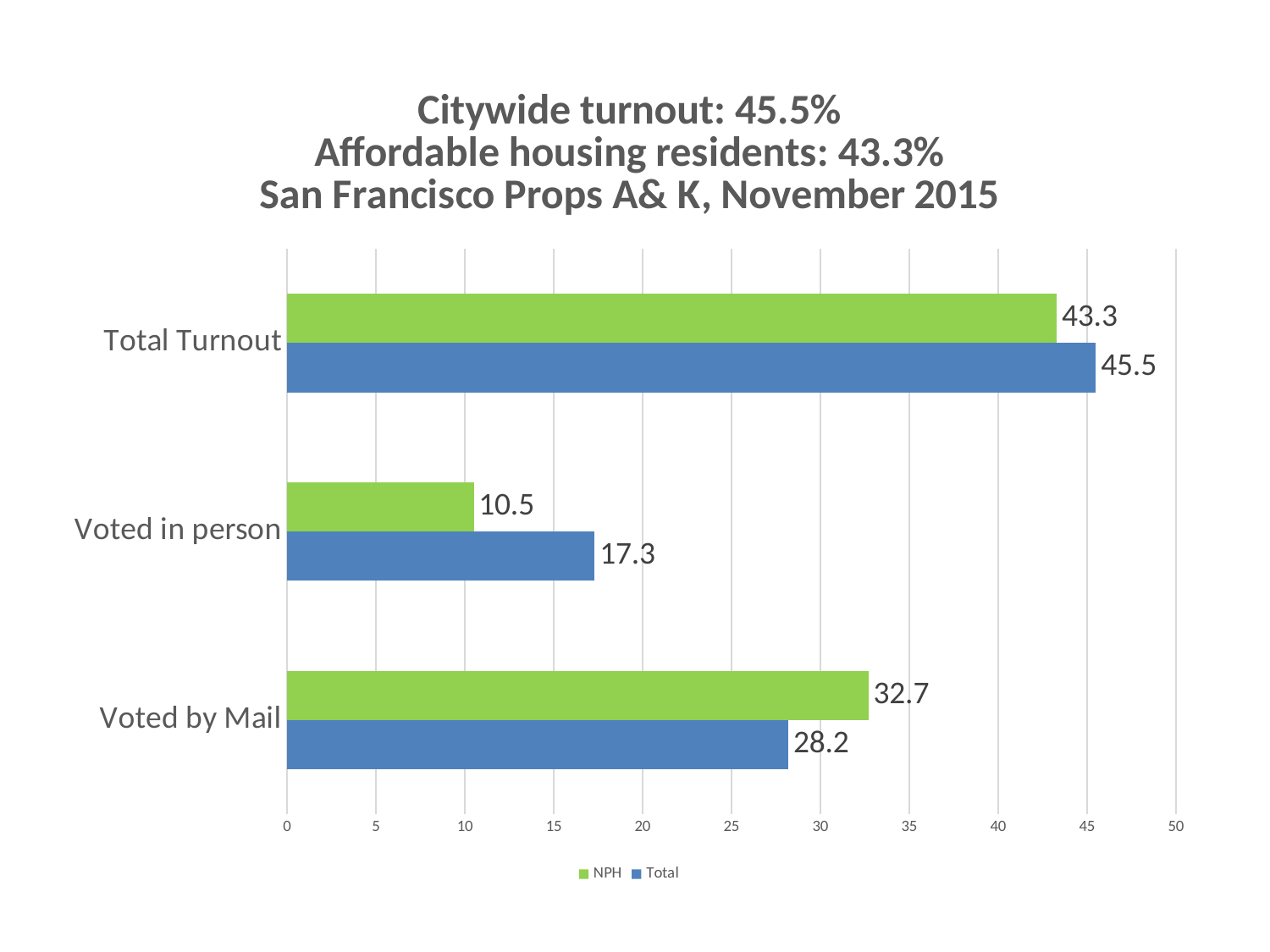
What is the difference between the NPH and Total values for Voted by Mail? 4.5 What is the NPH value for Total Turnout? 43.3 How many series does the legend list? 2 For Voted by Mail, which series has the larger value, NPH or Total? NPH What is the difference between the Total and NPH values for Voted in person? 6.8 How many categories are shown on the chart? 3 Which category has the lowest NPH value? Voted in person What kind of chart is shown on the slide? Bar chart What is the Total value for Voted in person? 17.3 Which category has the highest Total value? Total Turnout What is the NPH value for Voted by Mail? 32.7 What is the Total value for Voted by Mail? 28.2